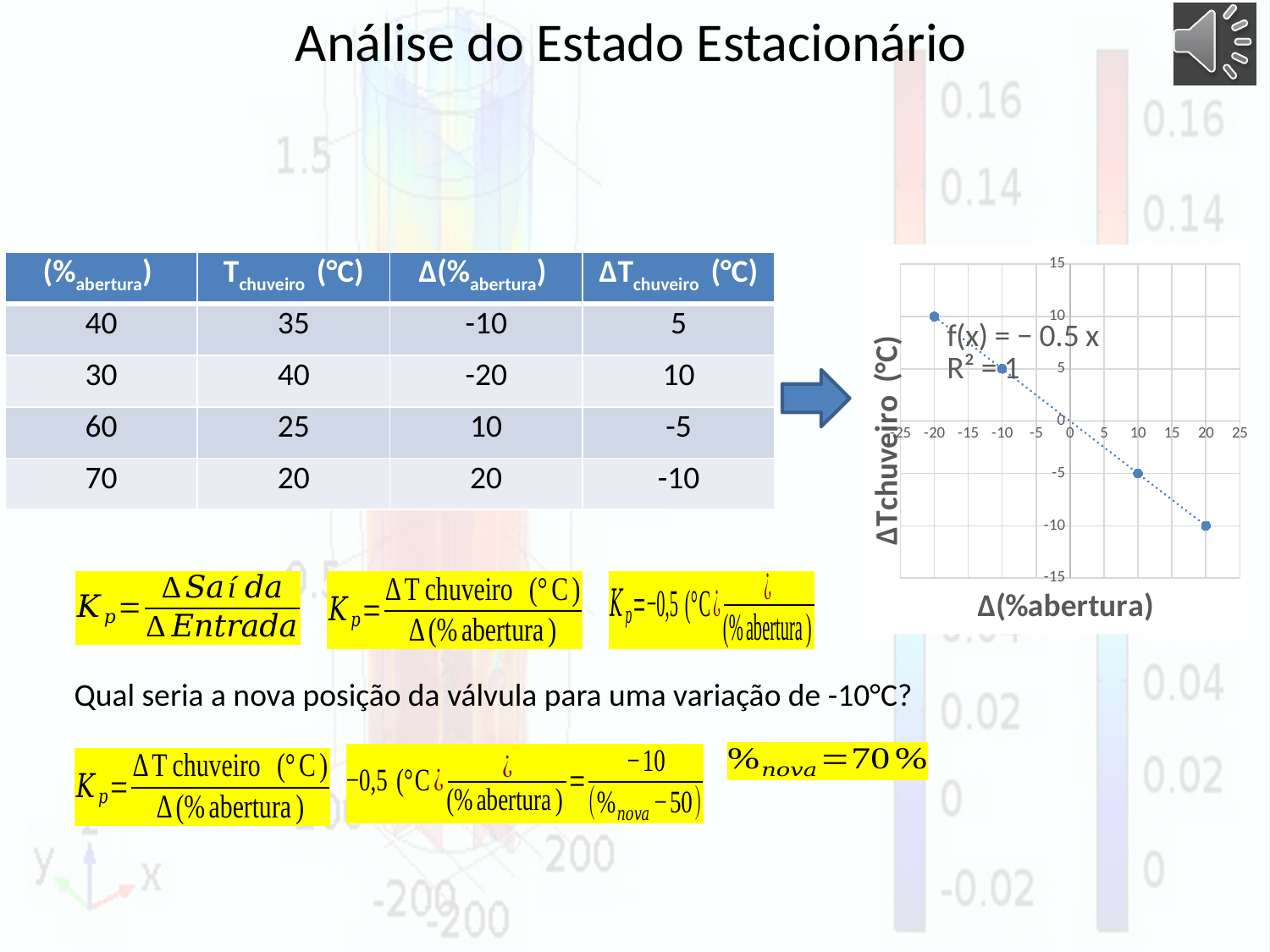
At which Δ(%abertura) value is ΔTchuveiro highest? -20 Does ΔTchuveiro rise or fall as Δ(%abertura) increases? fall What is the ΔTchuveiro (°C) value plotted at Δ(%abertura) = 10? -5 How many data points are plotted in the chart? 4 At which Δ(%abertura) value is ΔTchuveiro lowest? 20 What is the ΔTchuveiro (°C) value plotted at Δ(%abertura) = -20? 10 What kind of chart is shown on the slide? scatter chart What is the R² value shown on the chart? 1 Which is larger: the ΔTchuveiro value at Δ(%abertura) = -10 or at Δ(%abertura) = 10? at -10 What is the ΔTchuveiro (°C) value plotted at Δ(%abertura) = 20? -10 What trendline equation is displayed on the chart? f(x) = − 0.5 x What is the difference between the ΔTchuveiro values at Δ(%abertura) = -20 and Δ(%abertura) = 20? 20